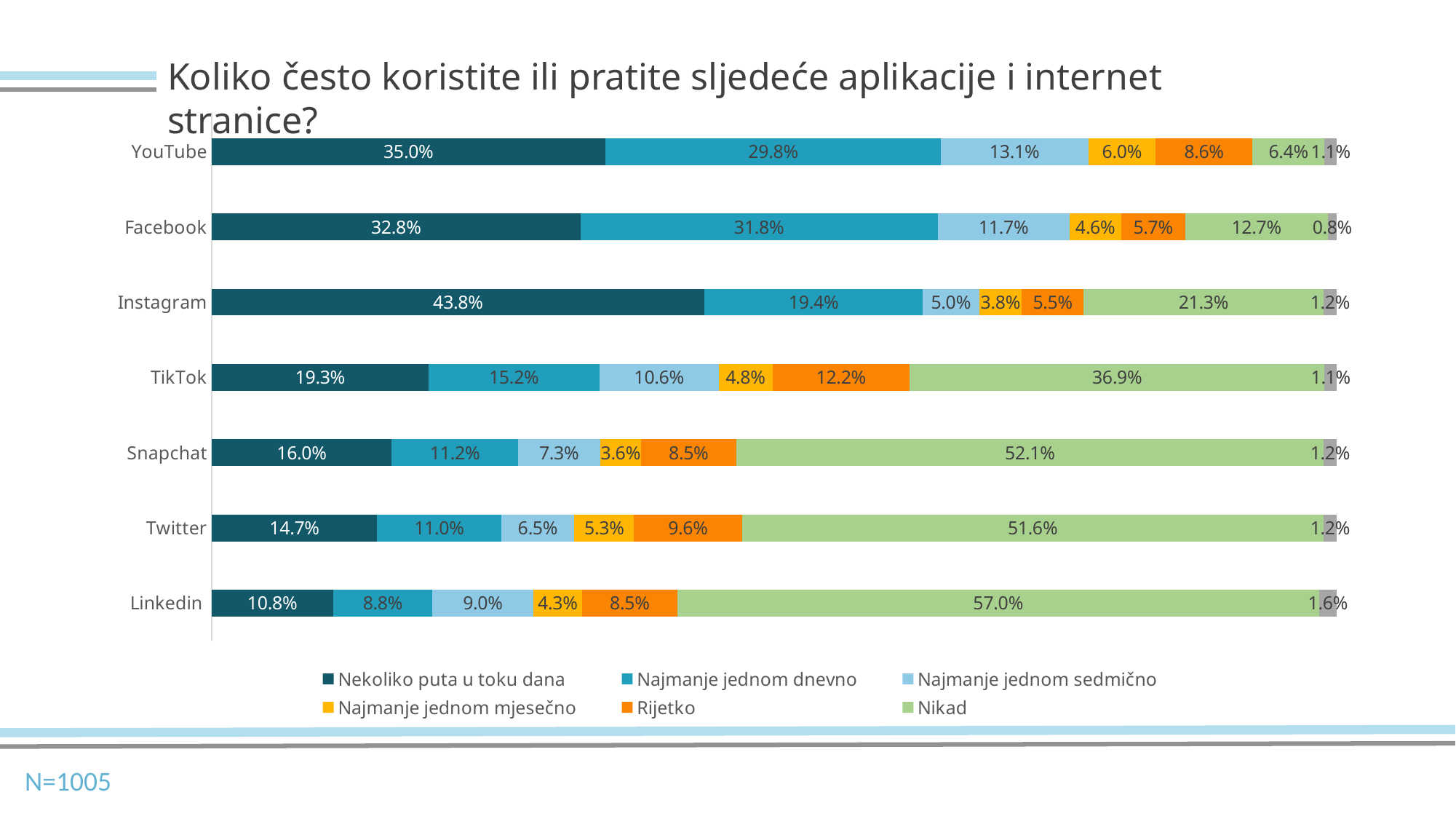
What sample size (N) is stated on the slide? N=1005 How many series does the legend list? 6 What is the 'Rijetko' value for TikTok? 12.2% How many platforms (categories) are shown in the chart? 7 What percentage of respondents use YouTube several times a day (Nekoliko puta u toku dana)? 35.0% Which platform has the highest 'Nekoliko puta u toku dana' share? Instagram What is the 'Nikad' value for Linkedin? 57.0% Which is larger: the 'Najmanje jednom dnevno' value for Facebook or for YouTube? Facebook What is the combined share of 'Nekoliko puta u toku dana' and 'Najmanje jednom dnevno' for Facebook? 64.6% What kind of chart is shown on the slide? Stacked bar chart Which platform has the lowest 'Nikad' share? YouTube What is the difference between the 'Nikad' values for Snapchat and Twitter? 0.5%